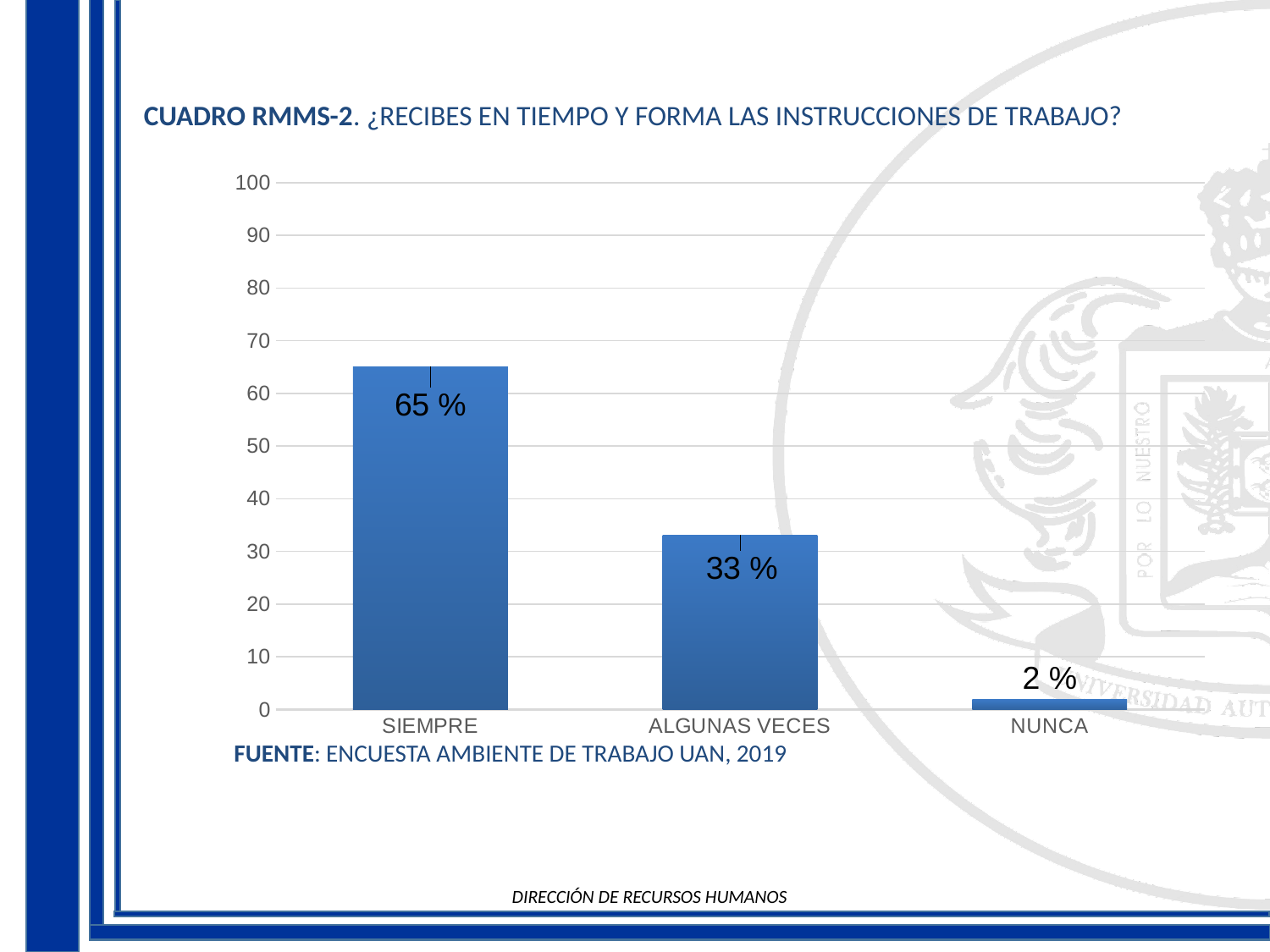
Which category has the highest value? SIEMPRE What kind of chart is shown on the slide? bar chart What is the value for ALGUNAS VECES? 33 % What is the difference between the values for SIEMPRE and ALGUNAS VECES? 32 % How many categories are shown on the x axis? 3 What is the value for SIEMPRE? 65 % What is the difference between the values for ALGUNAS VECES and NUNCA? 31 % What is the source cited below the chart? ENCUESTA AMBIENTE DE TRABAJO UAN, 2019 Which category has the lowest value? NUNCA What is the value for NUNCA? 2 % Is the value for SIEMPRE greater or less than 60? greater Which is larger, the value for ALGUNAS VECES or the value for NUNCA? ALGUNAS VECES